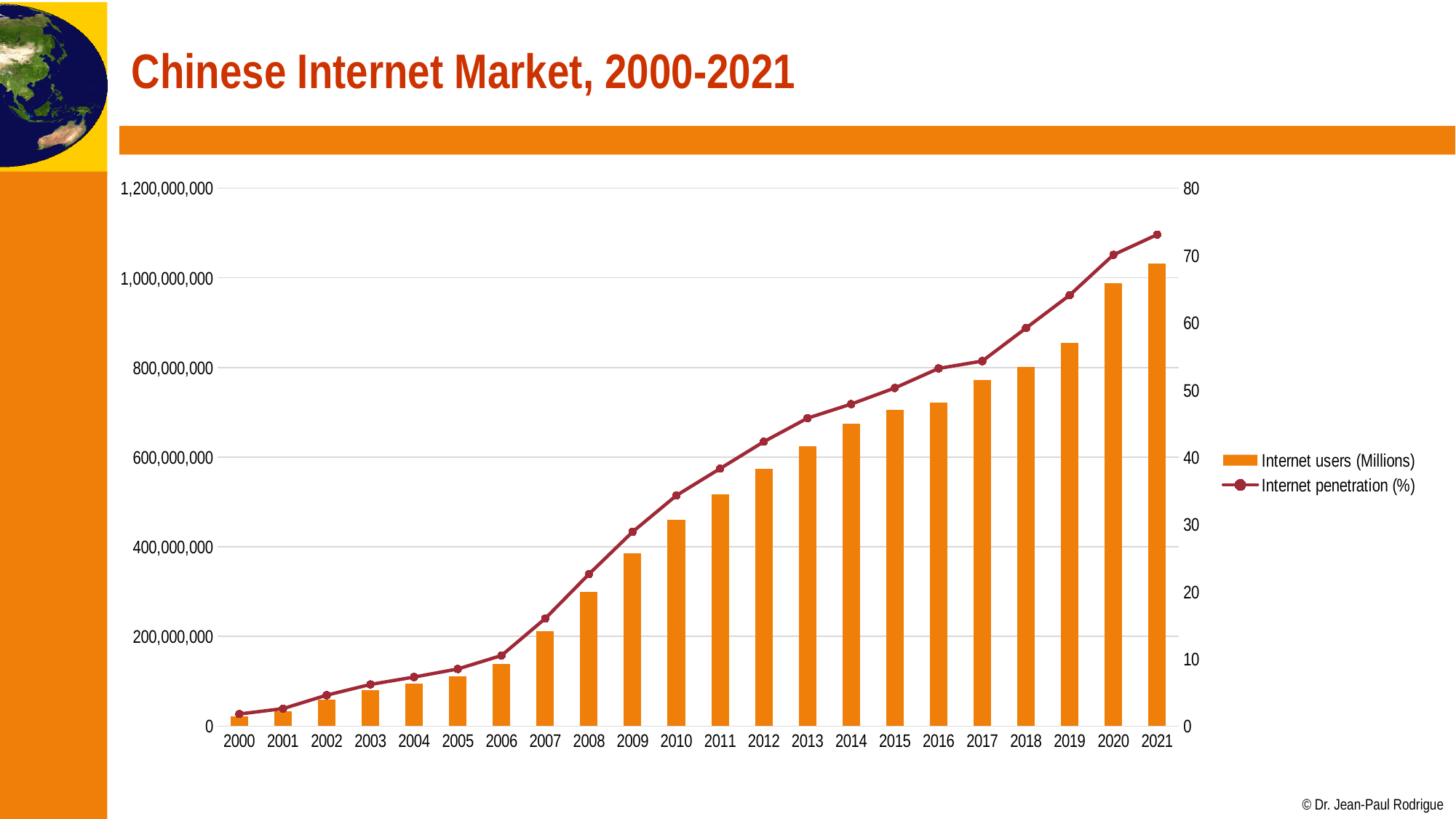
How many series does the legend list? 2 Is the number of Internet users in 2019 greater or less than 1,000,000,000? less Is the number of Internet users in 2010 greater or less than 400,000,000? greater Is the number of Internet users in 2008 greater or less than 400,000,000? less How many years are plotted along the x axis? 22 Which year has more Internet users, 2010 or 2015? 2015 Which year has the lowest Internet penetration (%)? 2000 What kind of chart is shown on the slide? A combined bar and line chart Does Internet penetration (%) rise or fall from 2000 to 2021? rise Which year has the highest number of Internet users? 2021